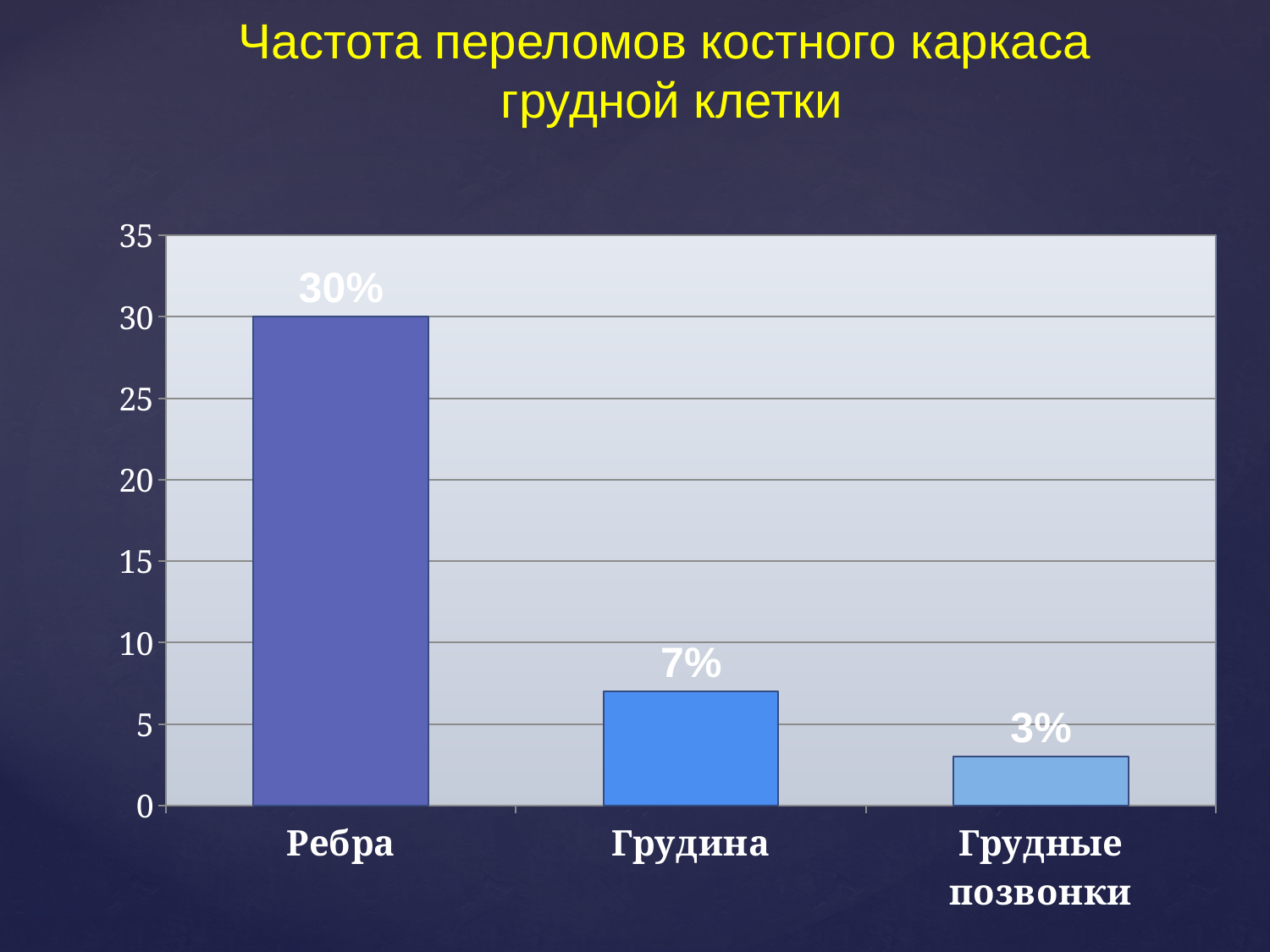
How many categories are shown on the chart? 3 What is the value for Грудина? 7% What is the value for Грудные позвонки? 3% Which is larger, the value for Грудина or the value for Грудные позвонки? Грудина Is the value for Ребра greater or less than 25? greater Which category has the highest value? Ребра Which category has the lowest value? Грудные позвонки What is the difference between the values for Ребра and Грудина? 23% What is the title of the slide? Частота переломов костного каркаса грудной клетки What kind of chart is shown on the slide? bar chart What is the value for Ребра? 30% What is the difference between the values for Грудина and Грудные позвонки? 4%